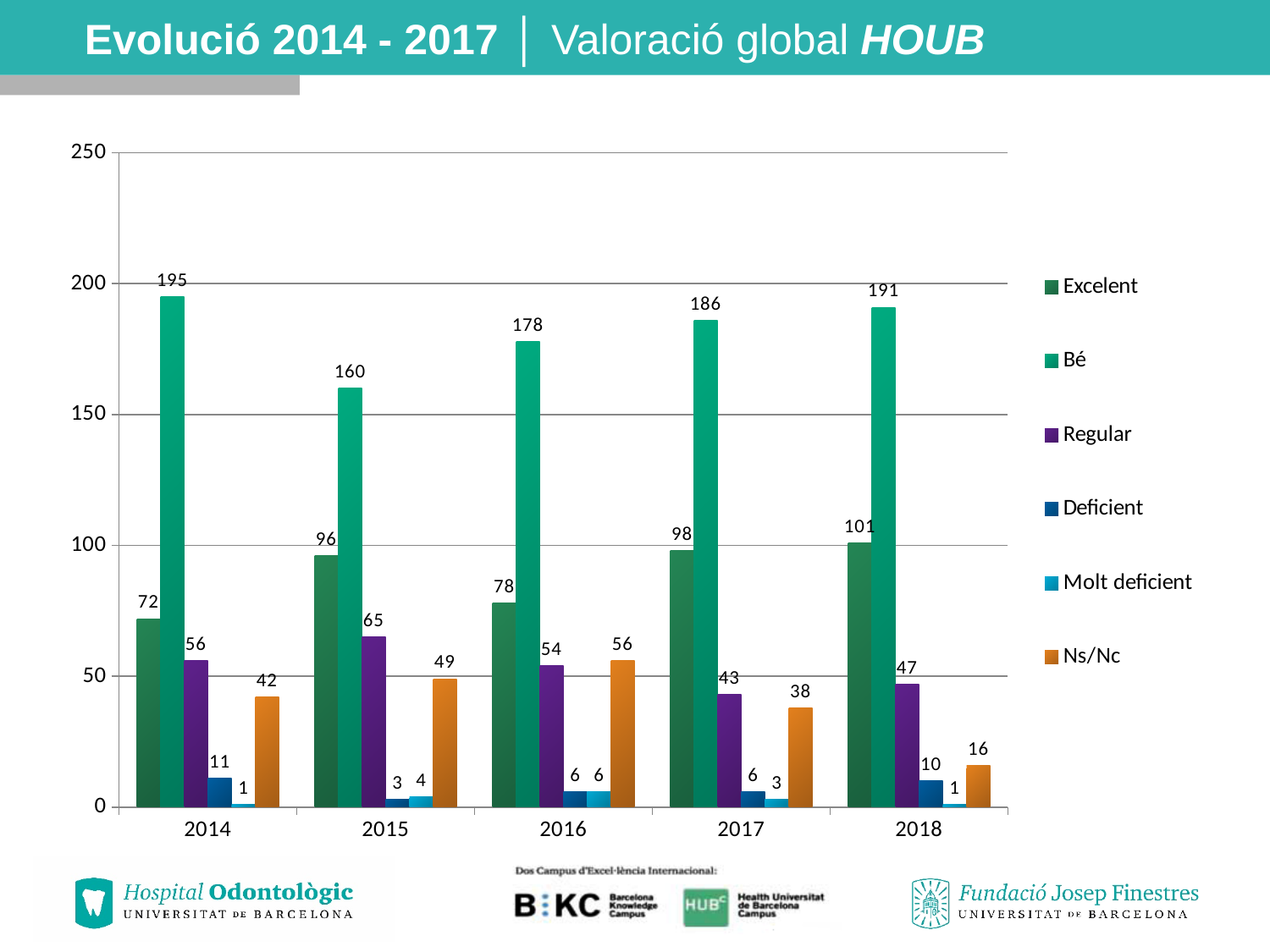
In which year is the Bé value the lowest? 2015 How many series does the legend list? 6 What is the value for Excelent in 2018? 101 What is the difference between the Bé values for 2014 and 2015? 35 What is the value for Bé in 2014? 195 What is the value for Regular in 2015? 65 What kind of chart is shown on the slide? Bar chart Does the Ns/Nc value rise or fall from 2016 to 2018? Fall How many years are shown on the x axis? 5 Which is larger, the Ns/Nc value in 2017 or the Ns/Nc value in 2018? 2017 What is the value for Ns/Nc in 2016? 56 In which year is the Excelent value the highest? 2018